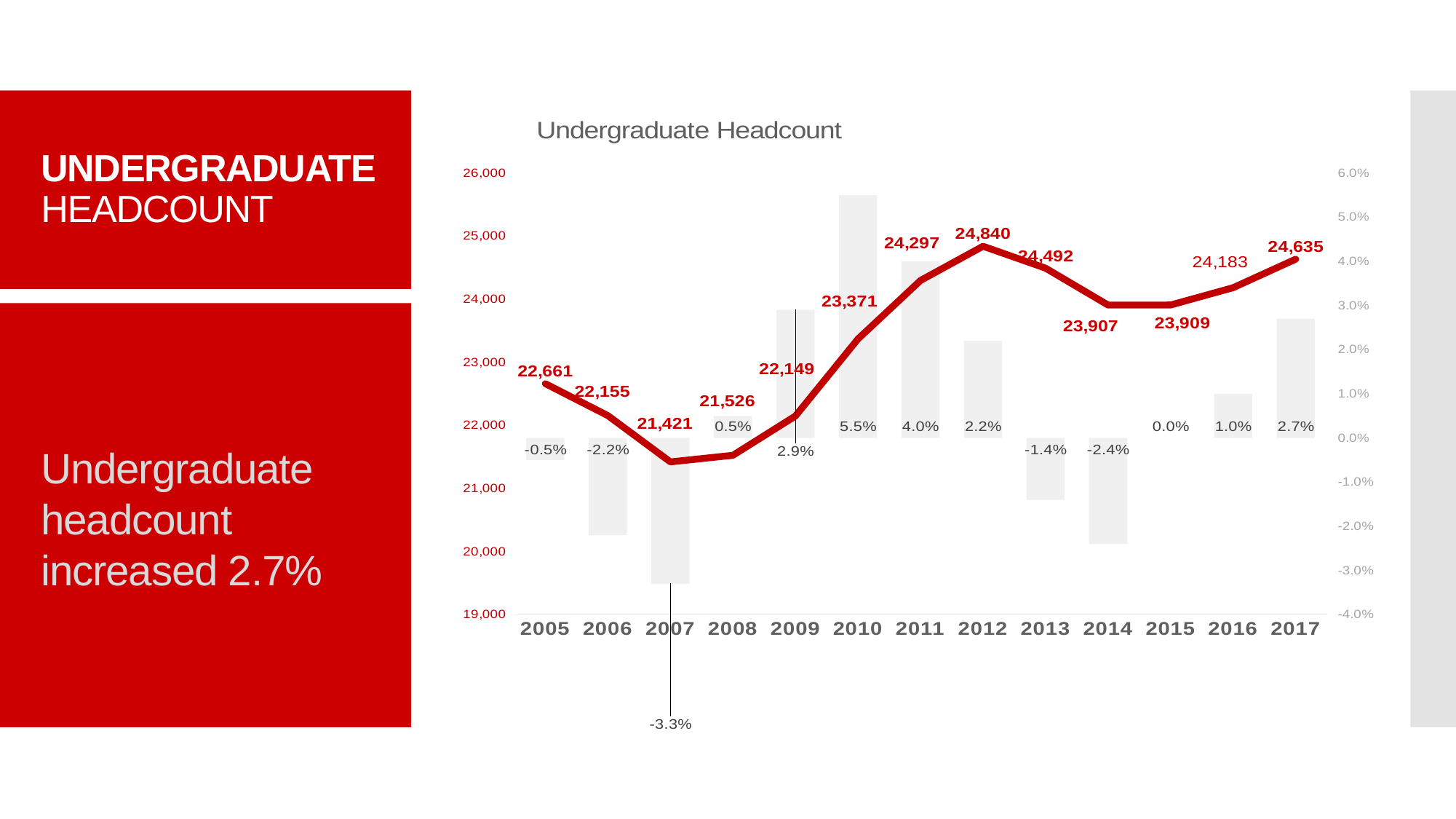
What is the undergraduate headcount for 2012? 24,840 Which year has the highest undergraduate headcount? 2012 What is the title of the chart? Undergraduate Headcount How many years are shown on the x axis of the chart? 13 Which year has the larger undergraduate headcount, 2011 or 2013? 2013 Which year shows the largest negative percentage change? 2007 Which year has the lowest undergraduate headcount? 2007 What is the difference in undergraduate headcount between 2017 and 2016? 452 What is the percentage change shown for 2010? 5.5% What is the percentage change shown for 2014? -2.4% Does the undergraduate headcount rise or fall from 2007 to 2012? rise What is the undergraduate headcount for 2007? 21,421